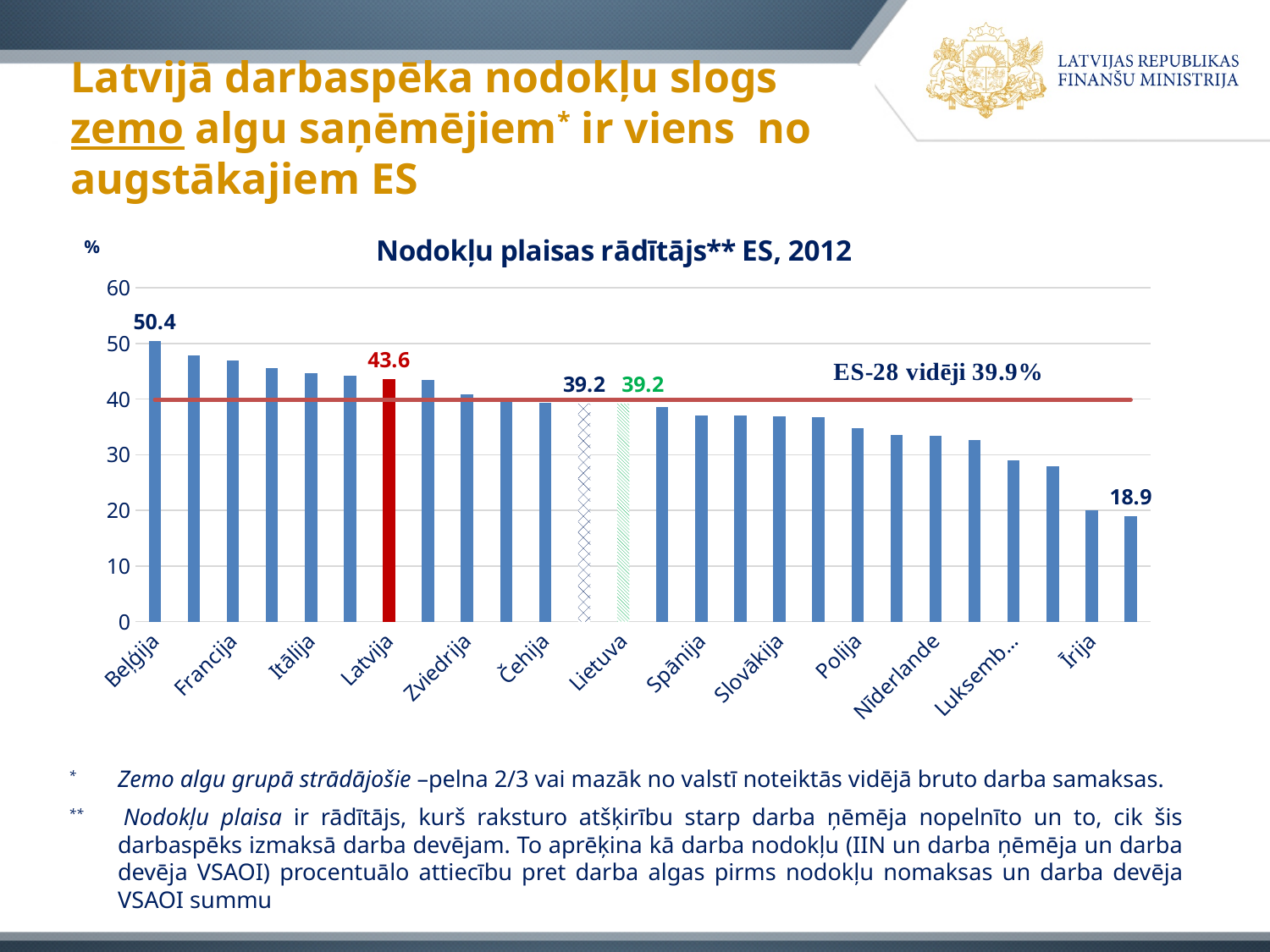
Which is larger: the value for Latvija or the ES-28 average? Latvija What kind of chart is shown on the slide? bar chart What colour is the bar for Latvija? red Is the value for Francija greater or less than 40? greater What is the value for Latvija? 43.6 Do the values generally rise or fall from left to right along the x axis? fall What is the ES-28 average value shown by the horizontal line? 39.9% What is the value for Beļģija? 50.4 What is the difference between the values for Beļģija and Latvija? 6.8 Is the value for Īrija greater or less than 30? less Which country has the highest value in the chart? Beļģija What is the title of the chart? Nodokļu plaisas rādītājs** ES, 2012